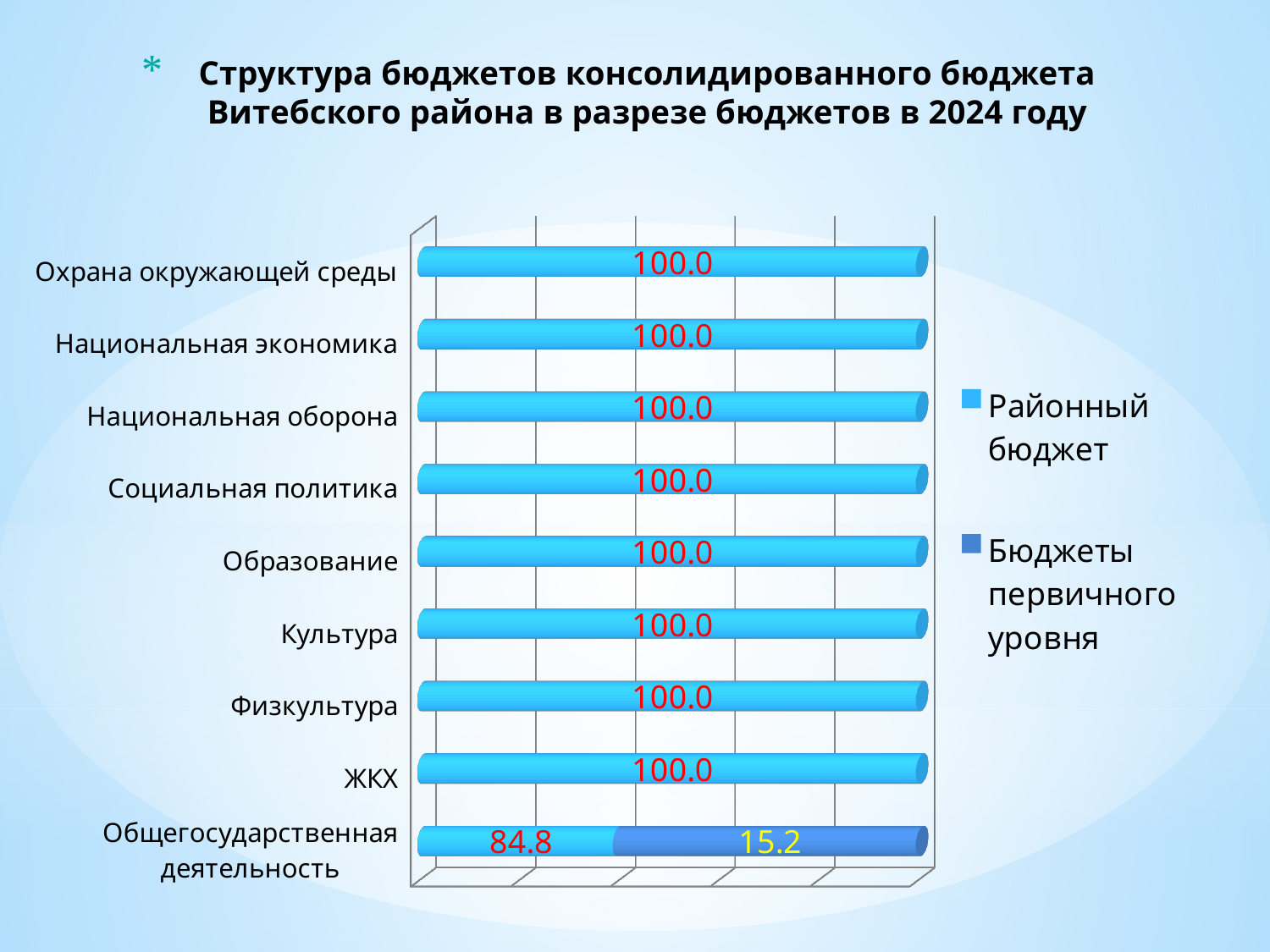
How many categories are plotted on the chart? 9 What is the value of Бюджеты первичного уровня for Общегосударственная деятельность? 15.2 Which legend entry is shown in the darker blue colour? Бюджеты первичного уровня What is the total of the stacked bar for Общегосударственная деятельность? 100.0 What is the value of Районный бюджет for Образование? 100.0 What is the value of Районный бюджет for ЖКХ? 100.0 What is the value of Районный бюджет for Общегосударственная деятельность? 84.8 What is the difference between the Районный бюджет and Бюджеты первичного уровня values for Общегосударственная деятельность? 69.6 Which is larger for Общегосударственная деятельность: Районный бюджет or Бюджеты первичного уровня? Районный бюджет Which category has the lowest value for Районный бюджет? Общегосударственная деятельность How many series does the legend list? 2 What kind of chart is shown on the slide? stacked bar chart